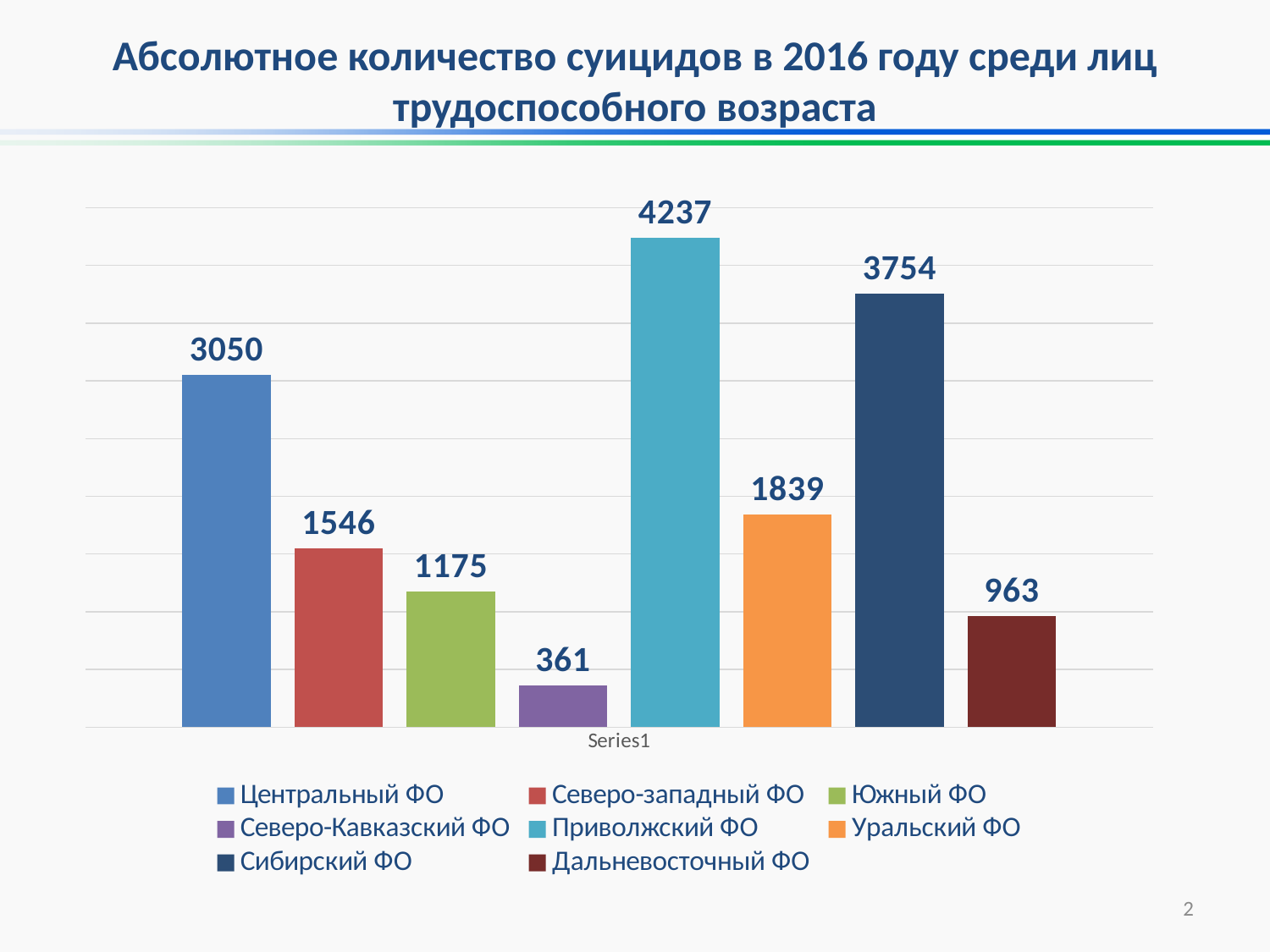
What is the value for Северо-Кавказский ФО? 361 Which federal district has the highest value? Приволжский ФО What is the value for Приволжский ФО? 4237 Which federal district has the lowest value? Северо-Кавказский ФО What is the difference between the values for Центральный ФО and Северо-западный ФО? 1504 What is the difference between the values for Приволжский ФО and Сибирский ФО? 483 What kind of chart is shown on the slide? bar chart What colour is the bar for Уральский ФО? orange How many entries does the legend list? 8 Which is larger, the value for Южный ФО or the value for Дальневосточный ФО? Южный ФО What is the value for Уральский ФО? 1839 How many federal districts are shown in the chart? 8